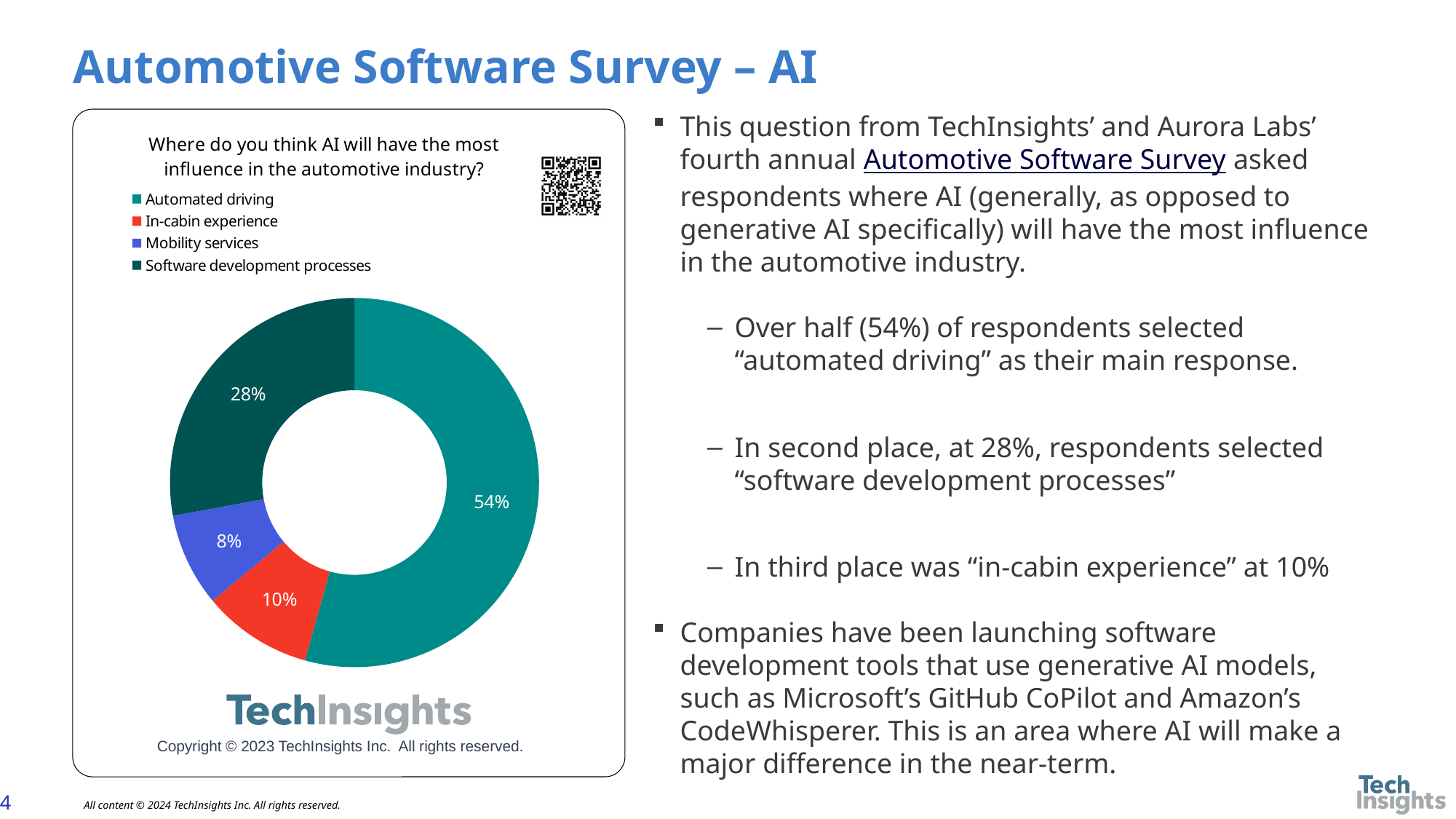
What share of respondents selected Mobility services? 8% Which category has the largest share of the pie? Automated driving Which category has the smallest share of the pie? Mobility services What share of respondents selected Automated driving? 54% Which is larger, the share for In-cabin experience or the share for Mobility services? In-cabin experience What kind of chart is shown on the slide? Pie chart (doughnut) What is the difference in percentage points between Automated driving and Software development processes? 26 What colour is the In-cabin experience slice? Red How many categories does the chart show? 4 What share of respondents selected In-cabin experience? 10% What share of respondents selected Software development processes? 28% What is the title of the chart? Where do you think AI will have the most influence in the automotive industry?